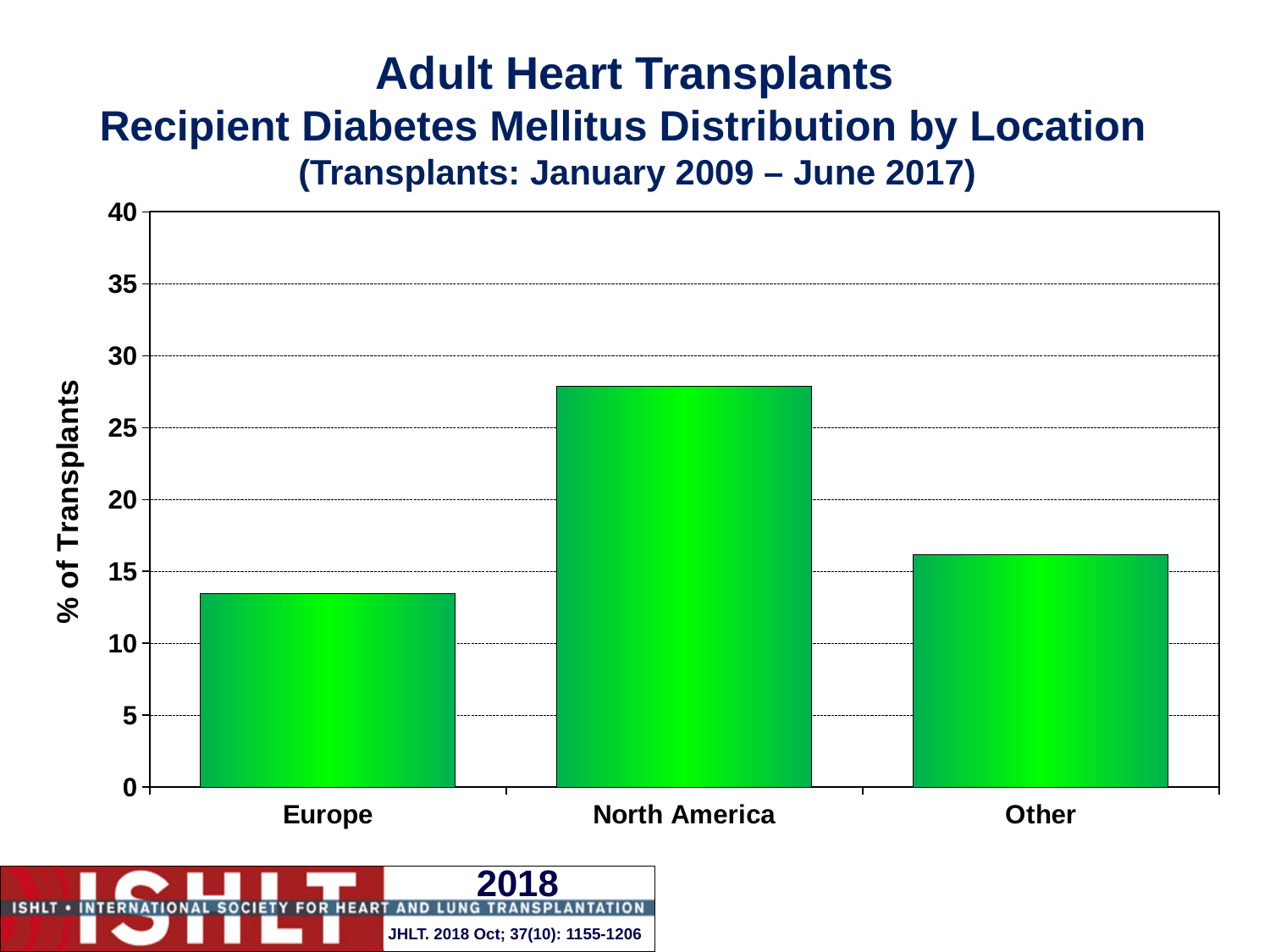
Is the value for Europe greater or less than 10? greater What transplant date range is given in the chart title? January 2009 – June 2017 Is the value for Other greater or less than 20? less How many location categories are plotted on the chart? 3 Which location has the highest percentage of transplants with recipient diabetes mellitus? North America What is the label on the y-axis of the chart? % of Transplants Which is larger, the value for Other or the value for Europe? Other Is the value for North America greater or less than 30? less Which location has the lowest percentage of transplants with recipient diabetes mellitus? Europe What kind of chart is shown on the slide? bar chart